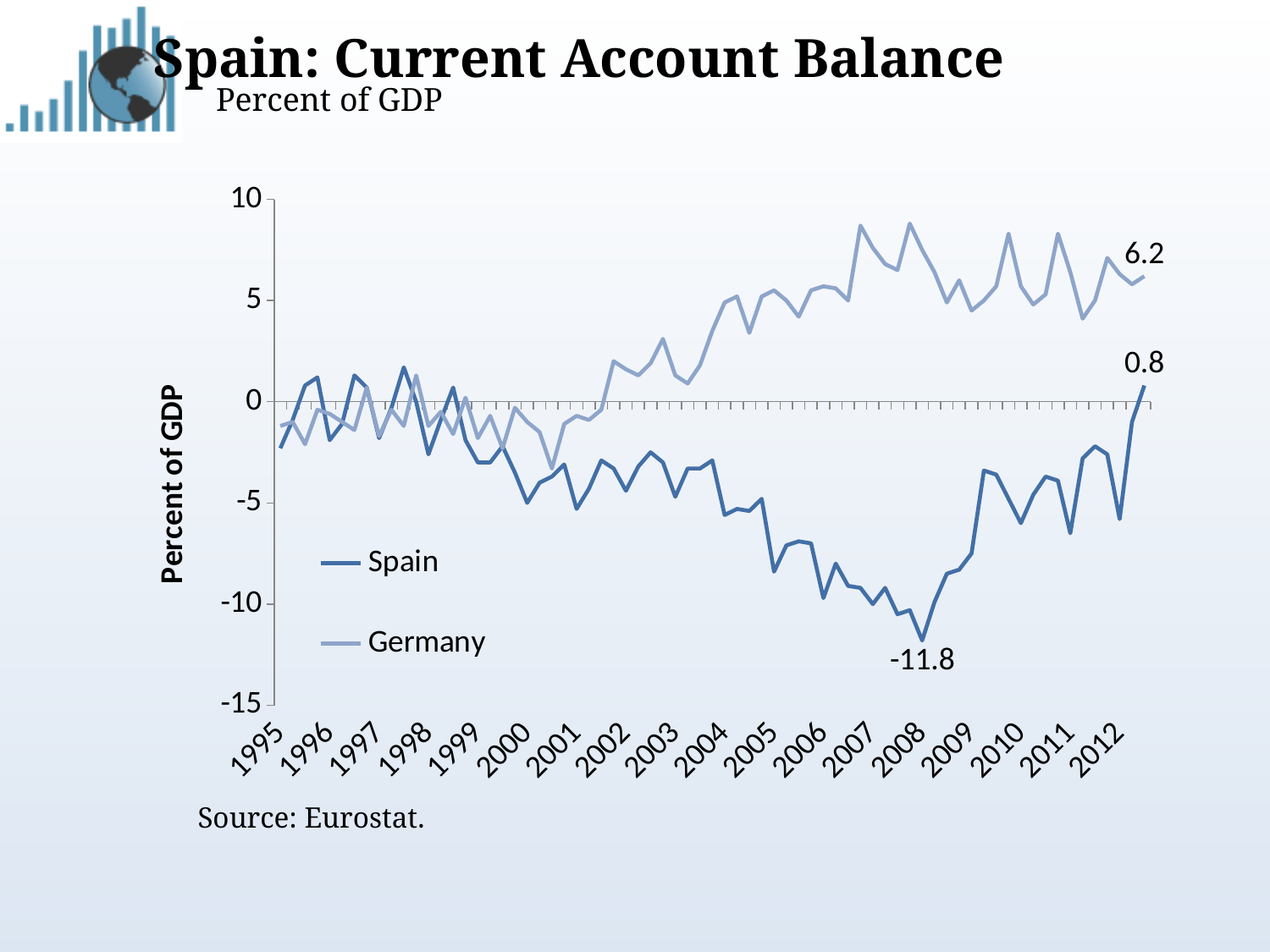
What is the last labelled value for Germany at the end of the series? 6.2 At the end of the series, which is larger: the value for Germany or the value for Spain? Germany What is the lowest labelled value reached by Spain? -11.8 What is the last labelled value for Spain at the end of the series? 0.8 What is the difference between the final labelled values for Germany (6.2) and Spain (0.8)? 5.4 Is the lowest value for Spain around 2008 greater or less than -10? less Is the peak value for Germany around 2007 greater or less than 5? greater What is the label on the vertical axis? Percent of GDP What kind of chart is shown on the slide? line chart Does the Spain line generally rise or fall between 2004 and 2008? fall How many series does the legend list? 2 Which series reaches the lowest value on the chart? Spain